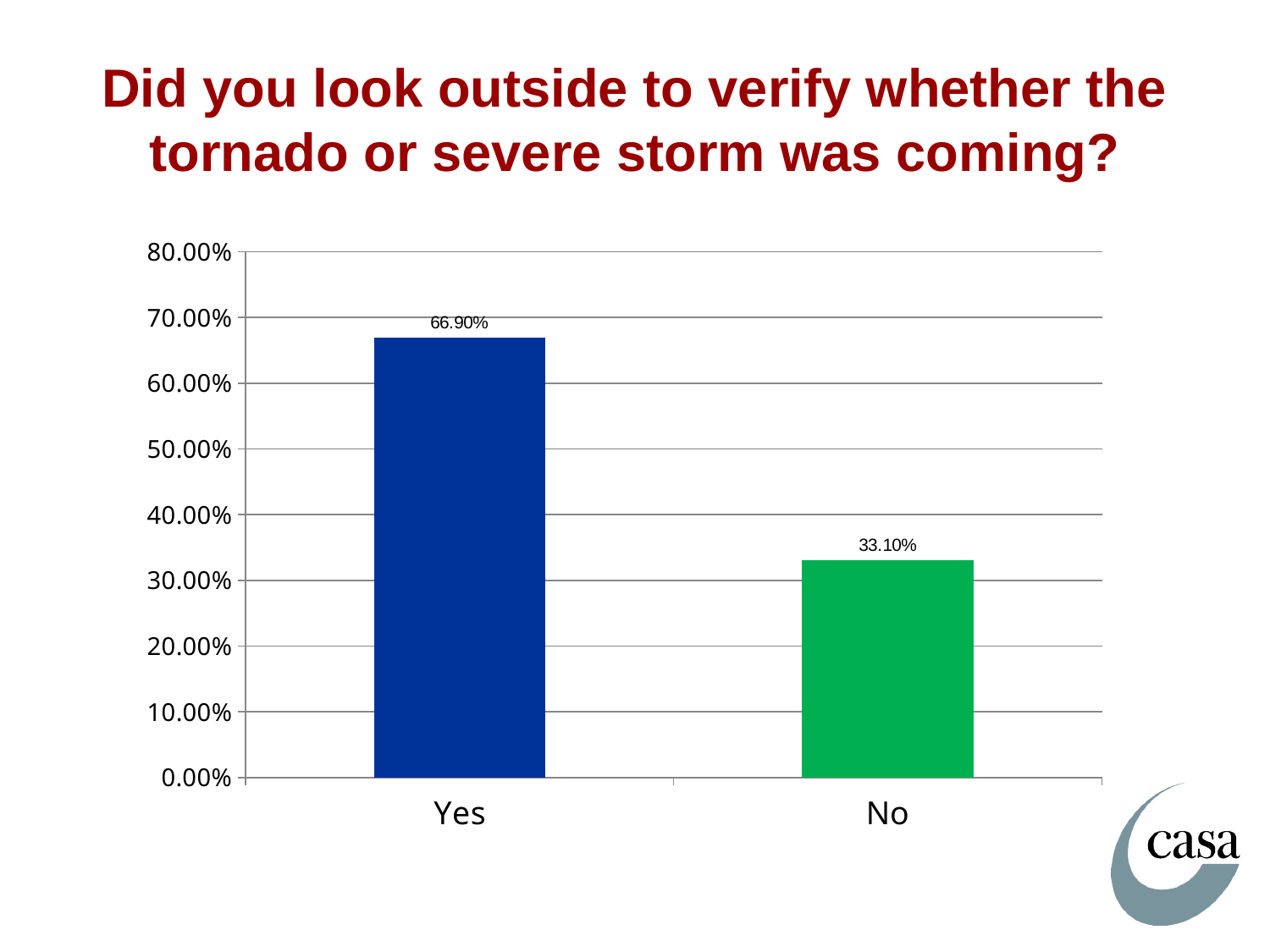
Is the value for No greater or less than 40.00%? less What is the highest value shown on the y axis? 80.00% What is the difference between the values for Yes and No? 33.80% Which category has the lowest value? No Which category has the highest value? Yes What colour is the bar for No? green What is the value for No? 33.10% Which is larger, the value for Yes or the value for No? Yes What is the value for Yes? 66.90% What kind of chart is shown on the slide? bar chart Is the value for Yes greater or less than 60.00%? greater How many categories are shown on the x axis? 2